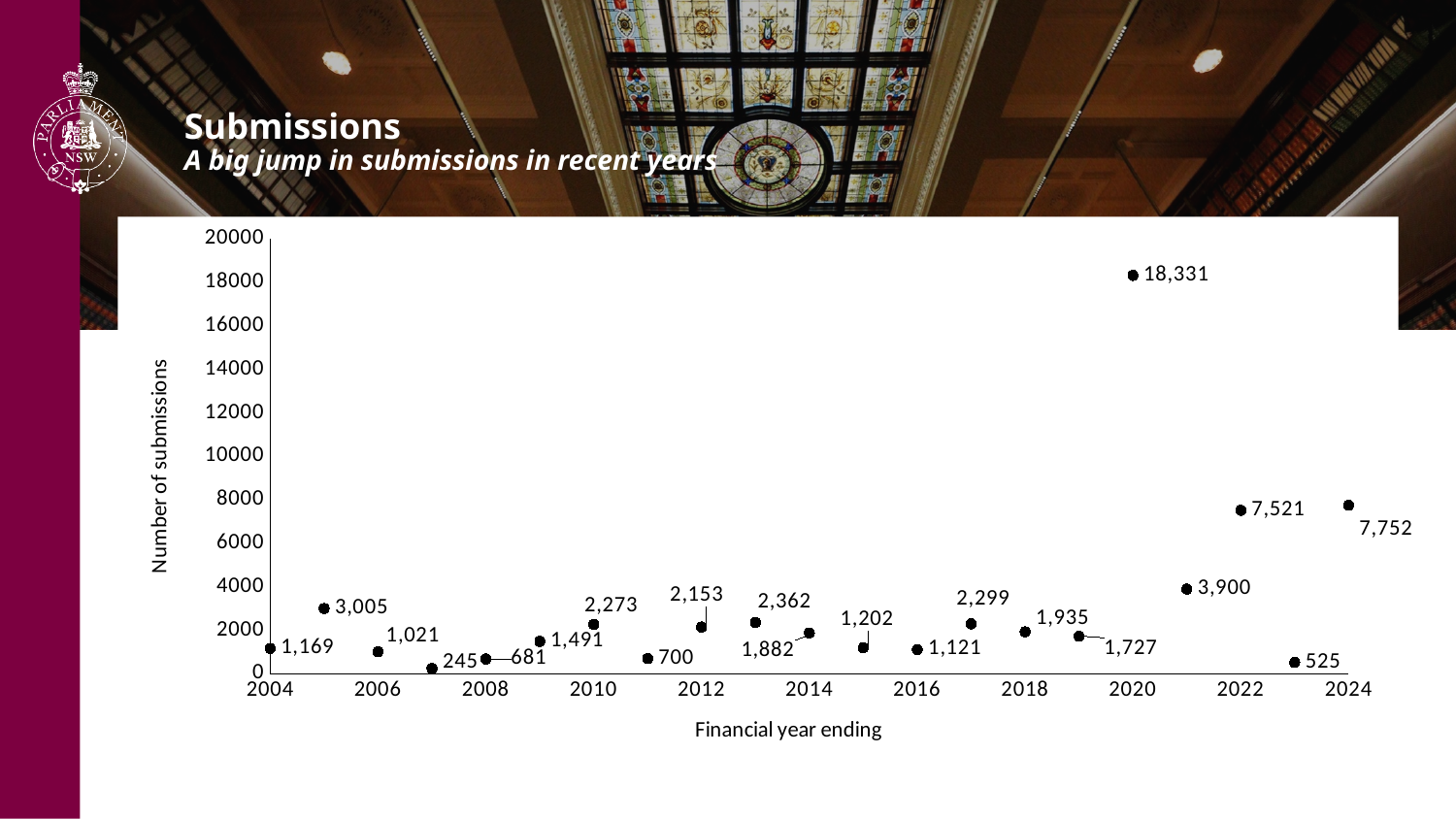
Which financial year ending has the highest number of submissions? 2020 Which financial year ending has the lowest number of submissions? 2007 What is the label of the x axis? Financial year ending How many data points are plotted on the chart? 21 What is the number of submissions for financial year ending 2024? 7,752 Is the value for financial year ending 2020 greater or less than 16000? greater What is the number of submissions for financial year ending 2020? 18,331 What is the label of the y axis? Number of submissions Which has more submissions: financial year ending 2021 or financial year ending 2005? 2021 What is the number of submissions for financial year ending 2007? 245 What is the difference in submissions between financial year ending 2024 and financial year ending 2022? 231 What is the number of submissions for financial year ending 2023? 525